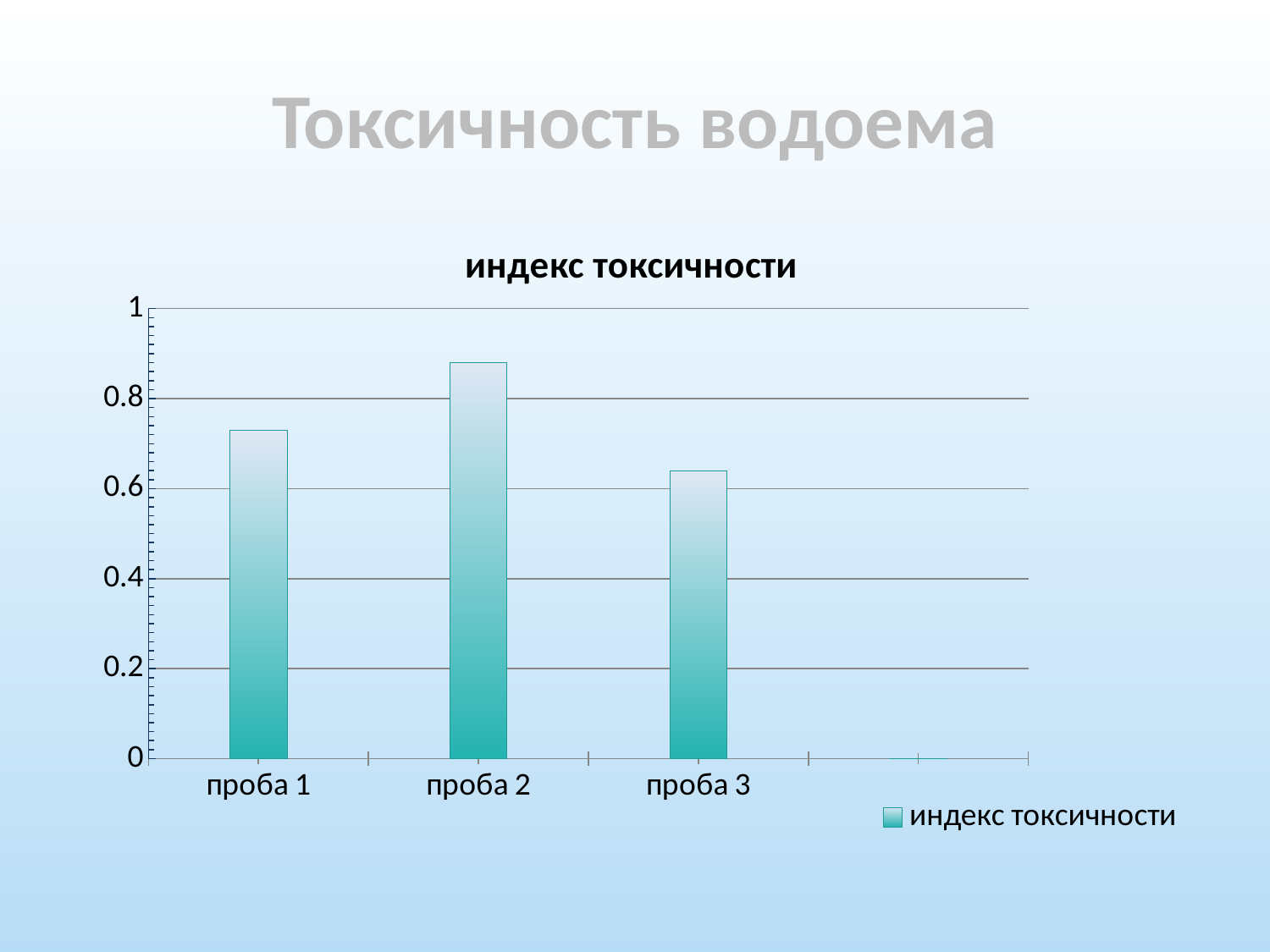
Which sample has the highest toxicity index? проба 2 Is the value for проба 2 greater or less than 0.8? greater What is the name of the series shown in the legend? индекс токсичности What type of chart is shown on the slide? bar chart What is the title of the chart? индекс токсичности Which has a larger toxicity index, проба 1 or проба 3? проба 1 Which has a larger toxicity index, проба 2 or проба 1? проба 2 How many series does the legend list? 1 Which sample has the lowest toxicity index? проба 3 Is the value for проба 1 greater or less than 0.8? less Is the value for проба 3 greater or less than 0.8? less How many categories (samples) are plotted on the chart? 3